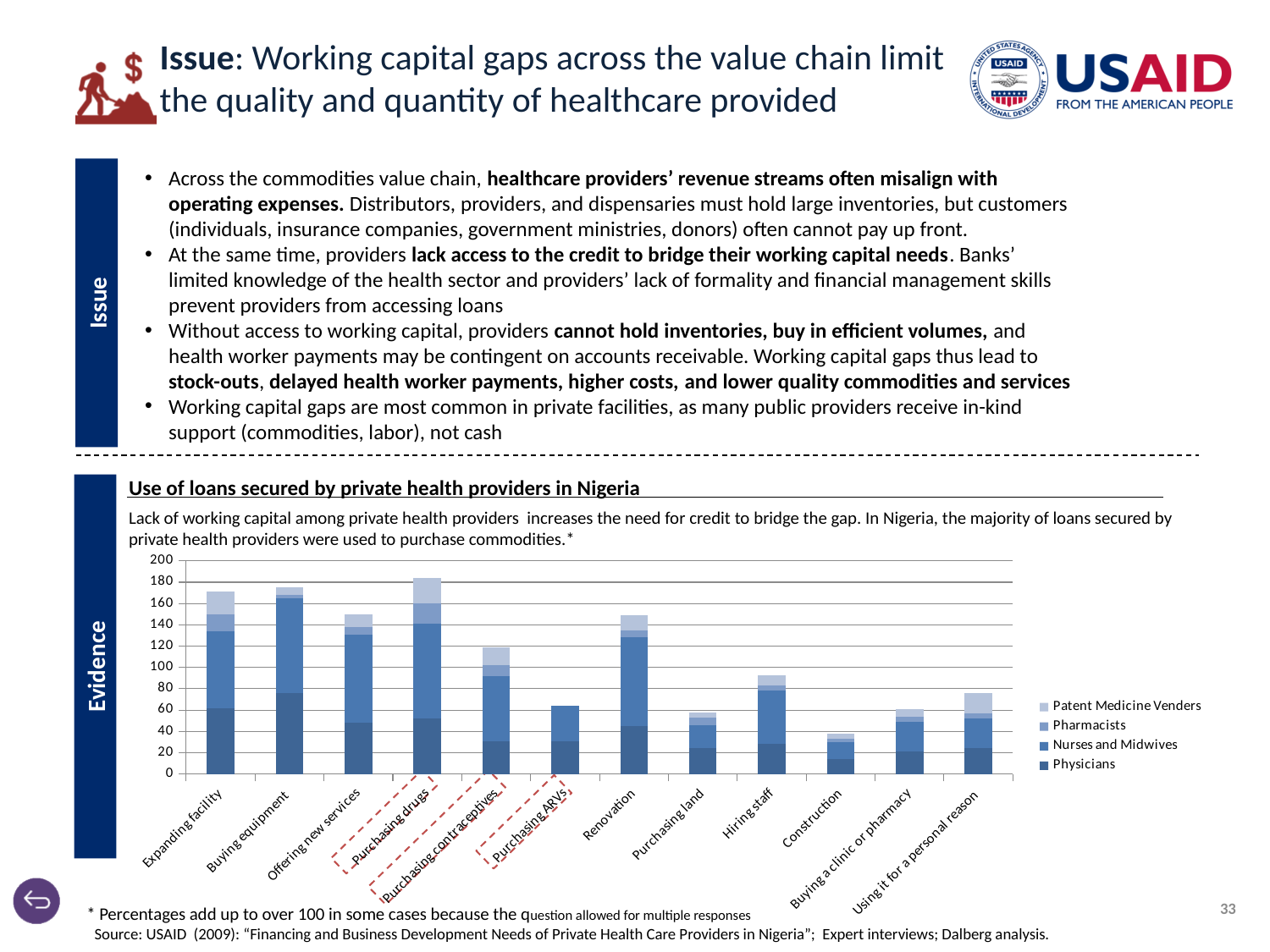
Is the total bar for Purchasing drugs greater or less than 160? greater Which legend entry is shown in the lightest blue colour? Patent Medicine Venders Is the total bar for Construction greater or less than 60? less Which has the larger total bar, Renovation or Purchasing land? Renovation Which series is shown at the bottom of each stacked bar, according to the legend? Physicians Which category has the lowest total bar in the chart? Construction Is the total bar for Purchasing contraceptives greater or less than 100? greater How many loan-use categories are shown on the x axis of the chart? 12 How many series does the chart's legend list? 4 Which has the larger total bar, Expanding facility or Purchasing contraceptives? Expanding facility What kind of chart is shown under 'Use of loans secured by private health providers in Nigeria'? Stacked bar chart